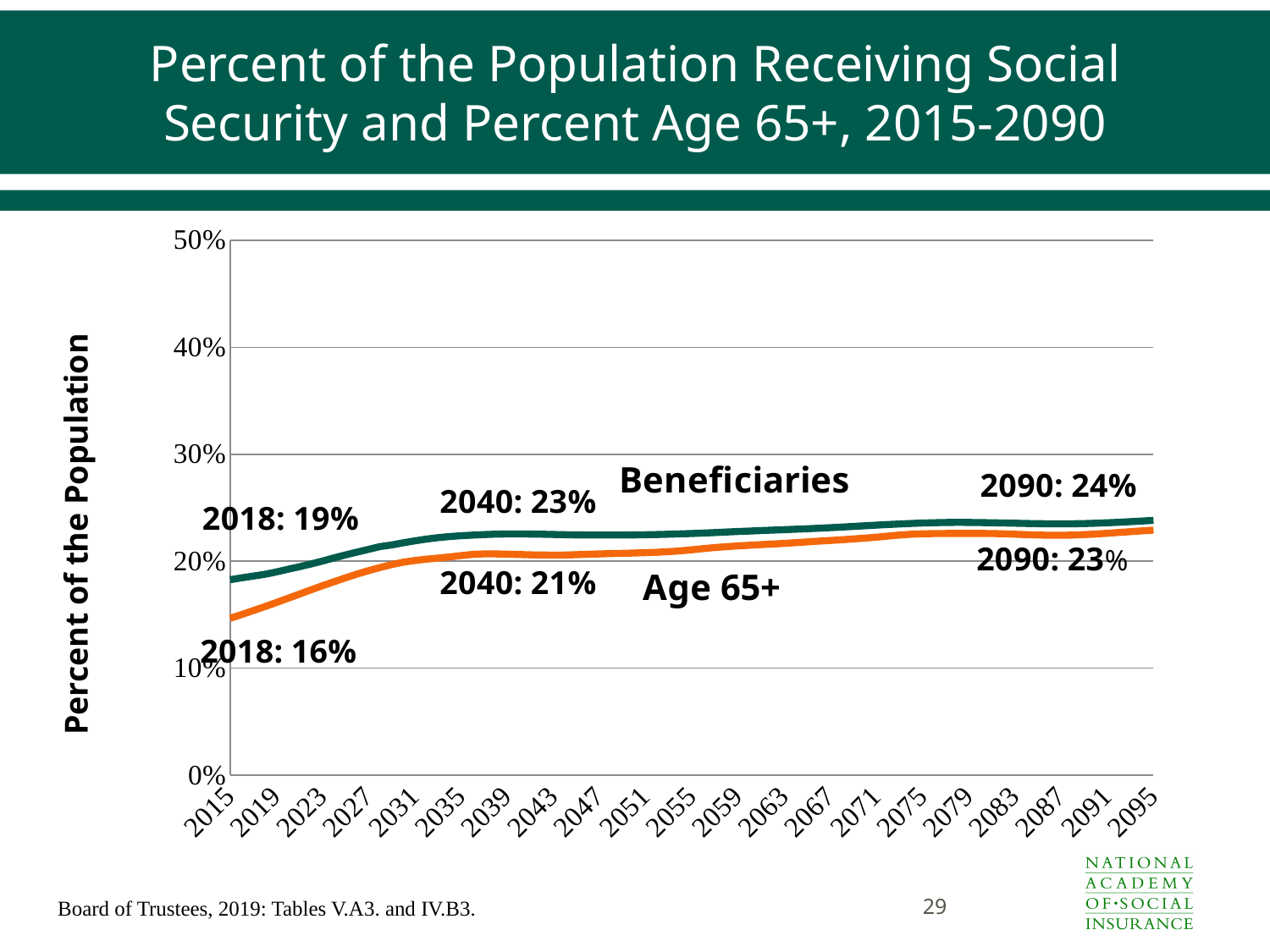
Is the Beneficiaries value in 2015 greater or less than 20%? less What is the difference between the Beneficiaries value and the Age 65+ value in 2018? 3 percentage points What percent of the population was age 65+ in 2018? 16% In 2040, which is larger: the Beneficiaries value or the Age 65+ value? Beneficiaries What value is labeled for Age 65+ in 2090? 23% Is the Age 65+ value in 2095 greater or less than 20%? greater What value is labeled for Beneficiaries in 2040? 23% How many data series are plotted on the chart? 2 What is the difference between the Beneficiaries value and the Age 65+ value in 2090? 1 percentage point What kind of chart is shown on the slide? line chart What percent of the population were Social Security beneficiaries in 2018? 19% Does the Beneficiaries line generally rise or fall from 2015 to 2095? rise